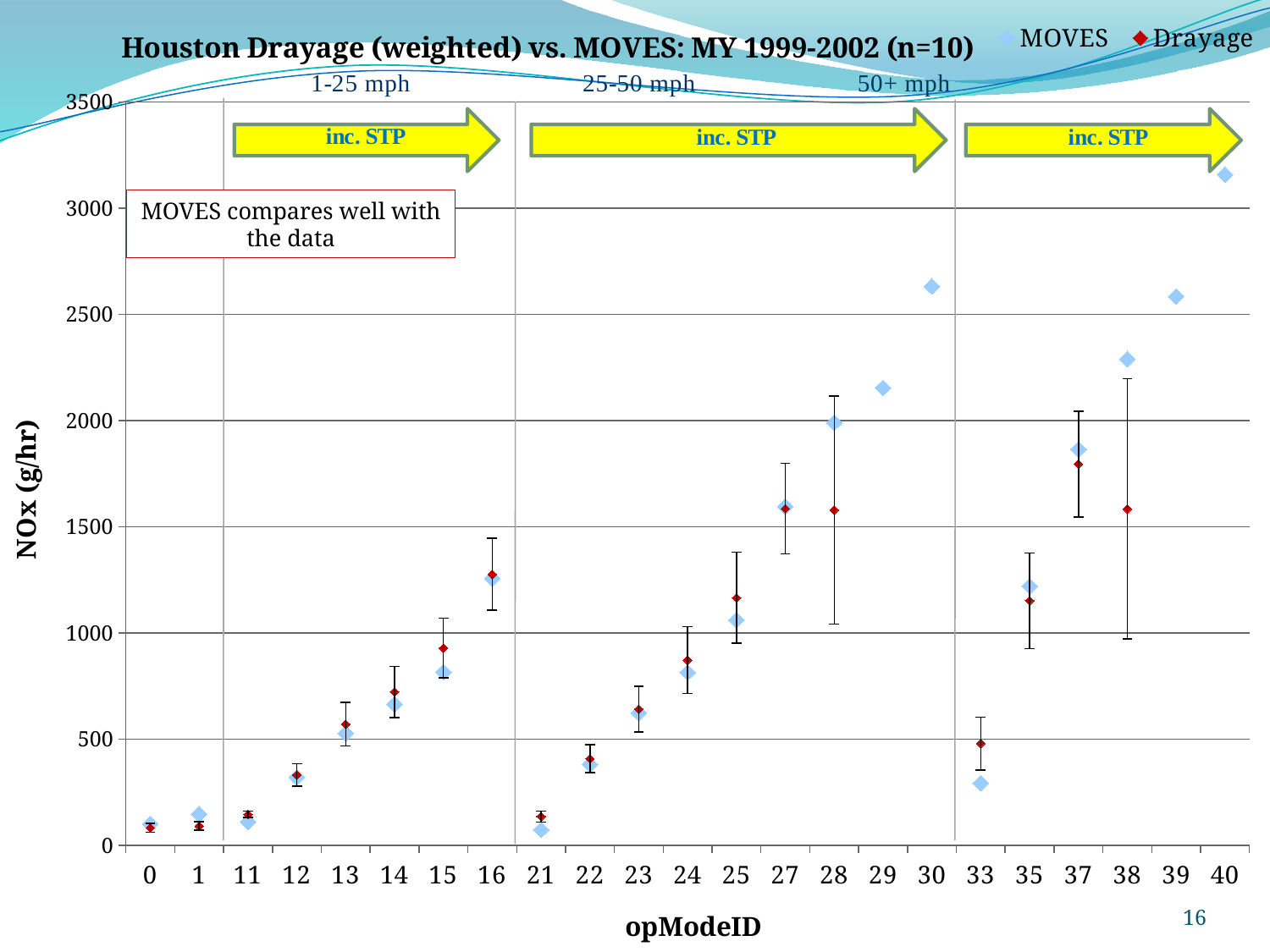
Is the Drayage value for opModeID 12 greater or less than 500? less Which opModeID has the lowest MOVES value? 21 Which opModeID has the highest Drayage value? 37 What kind of chart is shown on the slide? scatter chart How many opModeID categories are shown on the x axis? 23 At opModeID 38, which series has the larger value, MOVES or Drayage? MOVES Is the MOVES value for opModeID 30 greater or less than 2500? greater How many series does the legend list? 2 At opModeID 33, which series has the larger value, MOVES or Drayage? Drayage Which opModeID has the highest MOVES value? 40 Is the MOVES value for opModeID 40 greater or less than 3000? greater What is the title of the y axis? NOx (g/hr)